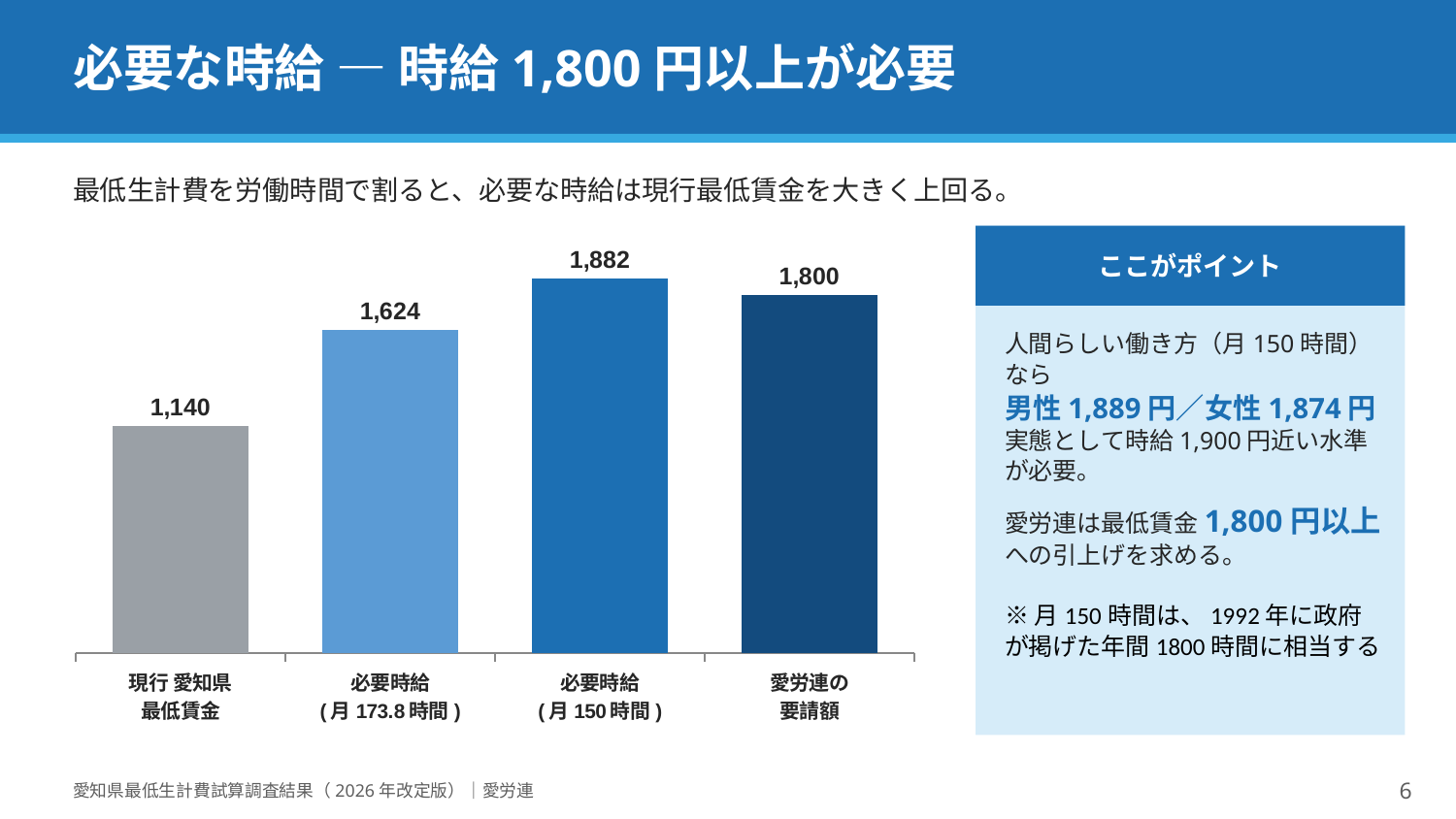
グラフで「現行 愛知県 最低賃金」の棒は何色ですか？ 灰色 「必要時給（月 173.8 時間）」と「愛労連の要請額」では、どちらの値が大きいですか？ 愛労連の要請額 「必要時給（月 150 時間）」と「現行 愛知県 最低賃金」の差はいくらですか？ 742 このグラフはどの種類のグラフですか？ 棒グラフ グラフで「必要時給（月 150 時間）」の値はいくらですか？ 1,882 グラフで最も値が高い項目はどれですか？ 必要時給（月 150 時間） グラフで「愛労連の要請額」の値はいくらですか？ 1,800 グラフで最も値が低い項目はどれですか？ 現行 愛知県 最低賃金 グラフには項目（棒）がいくつありますか？ 4 グラフで「必要時給（月 173.8 時間）」の値はいくらですか？ 1,624 「愛労連の要請額」と「必要時給（月 173.8 時間）」の差はいくらですか？ 176 グラフで「現行 愛知県 最低賃金」の値はいくらですか？ 1,140